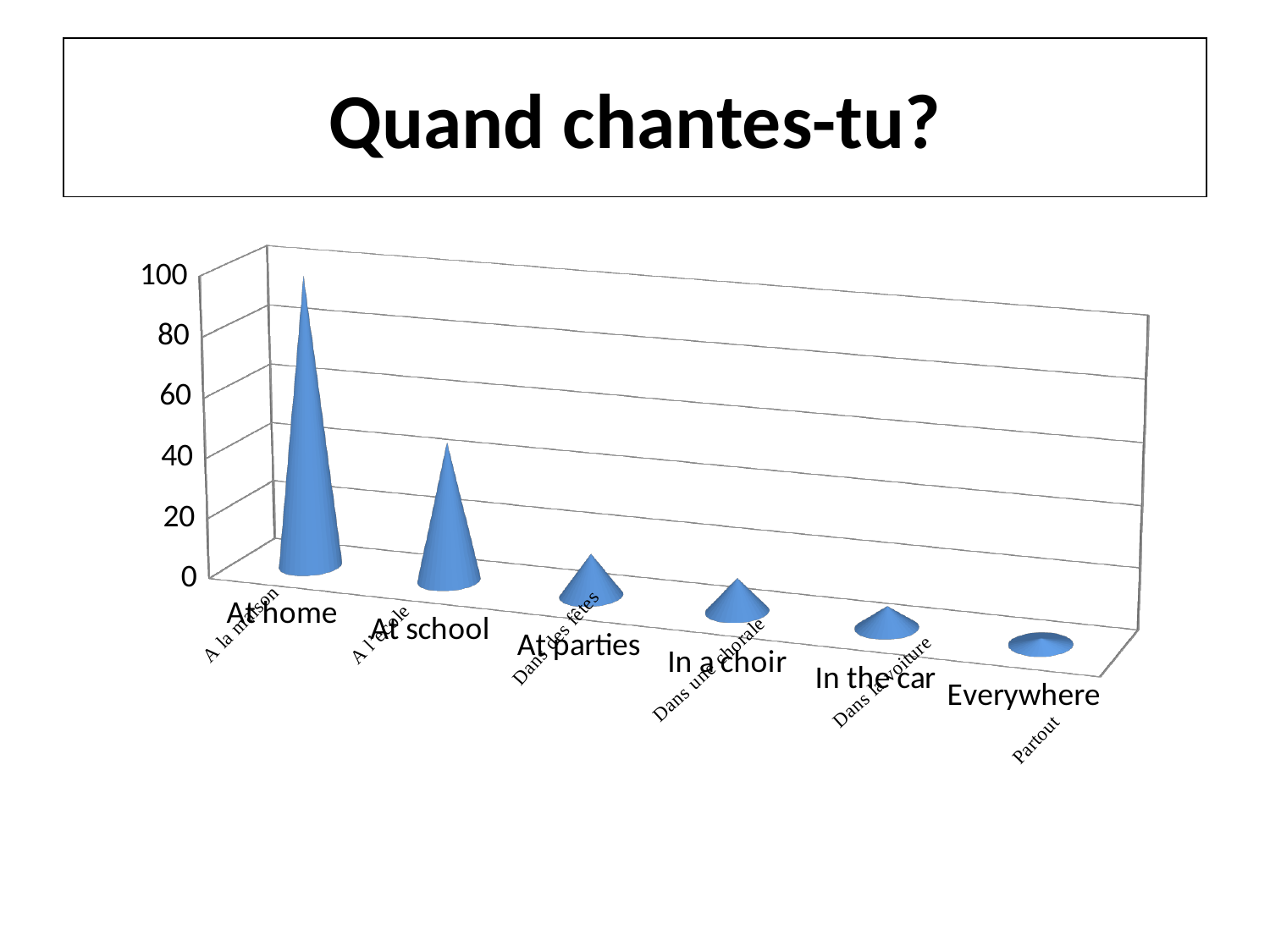
Which category has the highest value? At home Is the value for At school greater or less than 60? less What kind of chart is shown on the slide? Bar chart Do the values rise or fall from left to right along the x axis? Fall Is the value for Everywhere greater or less than 20? less Which is larger, the value for At home or the value for At school? At home Is the value for At home greater or less than 80? greater Which category has the lowest value? Everywhere Which is larger, the value for At school or the value for At parties? At school How many categories are shown on the x axis? 6